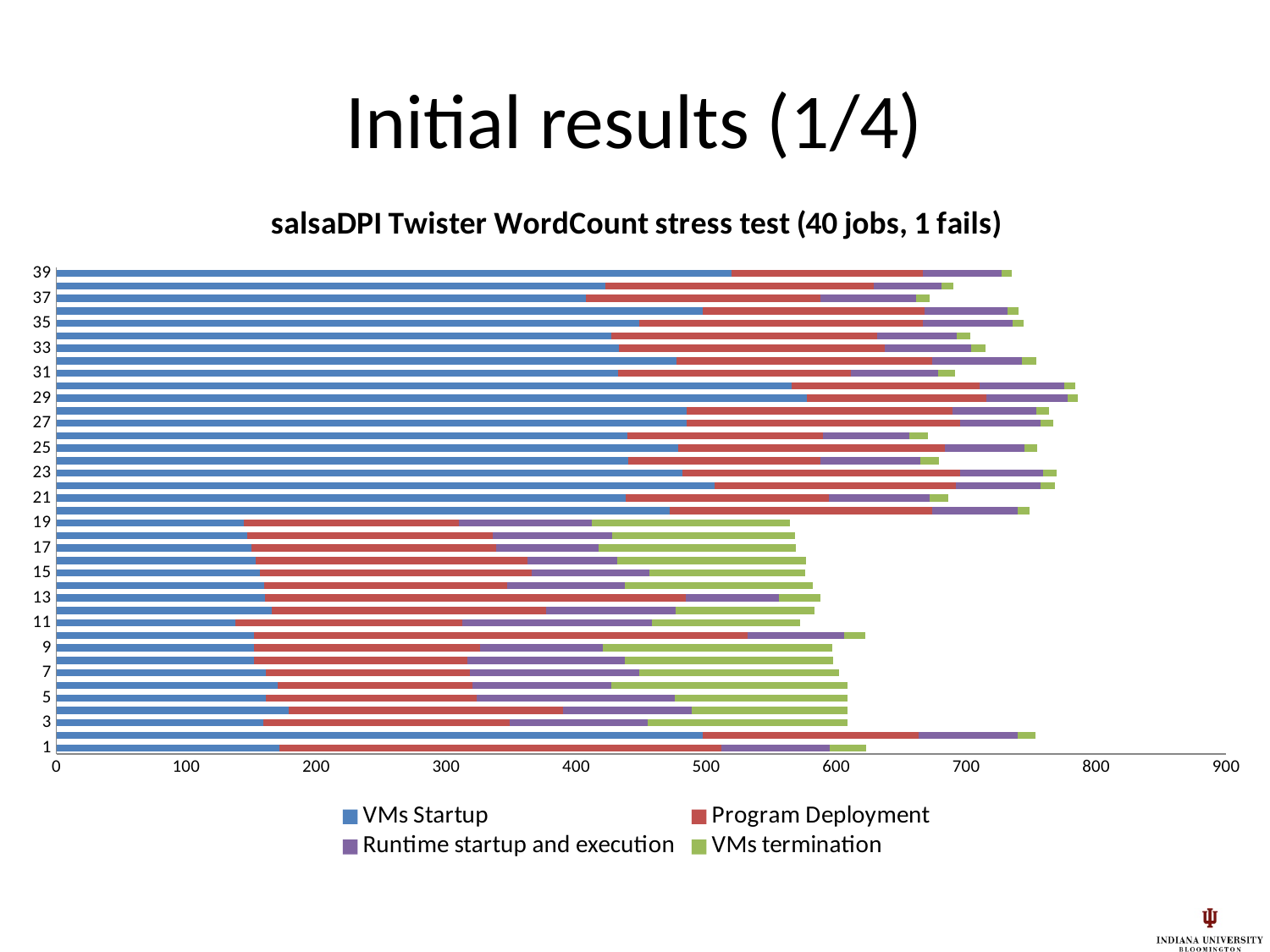
Is the total length of the bar for job 29 greater or less than 700? greater Which series is shown in green in the legend? VMs termination How many series does the legend list? 4 Which has the larger VMs Startup value, job 1 or job 39? Job 39 Is the total length of the bar for job 39 greater or less than 700? greater Is the total length of the bar for job 19 greater or less than 600? less What kind of chart is shown on the slide? Stacked bar chart Which has the longer total bar, job 29 or job 19? Job 29 What is the title of the chart? salsaDPI Twister WordCount stress test (40 jobs, 1 fails) What is the maximum value shown on the horizontal axis? 900